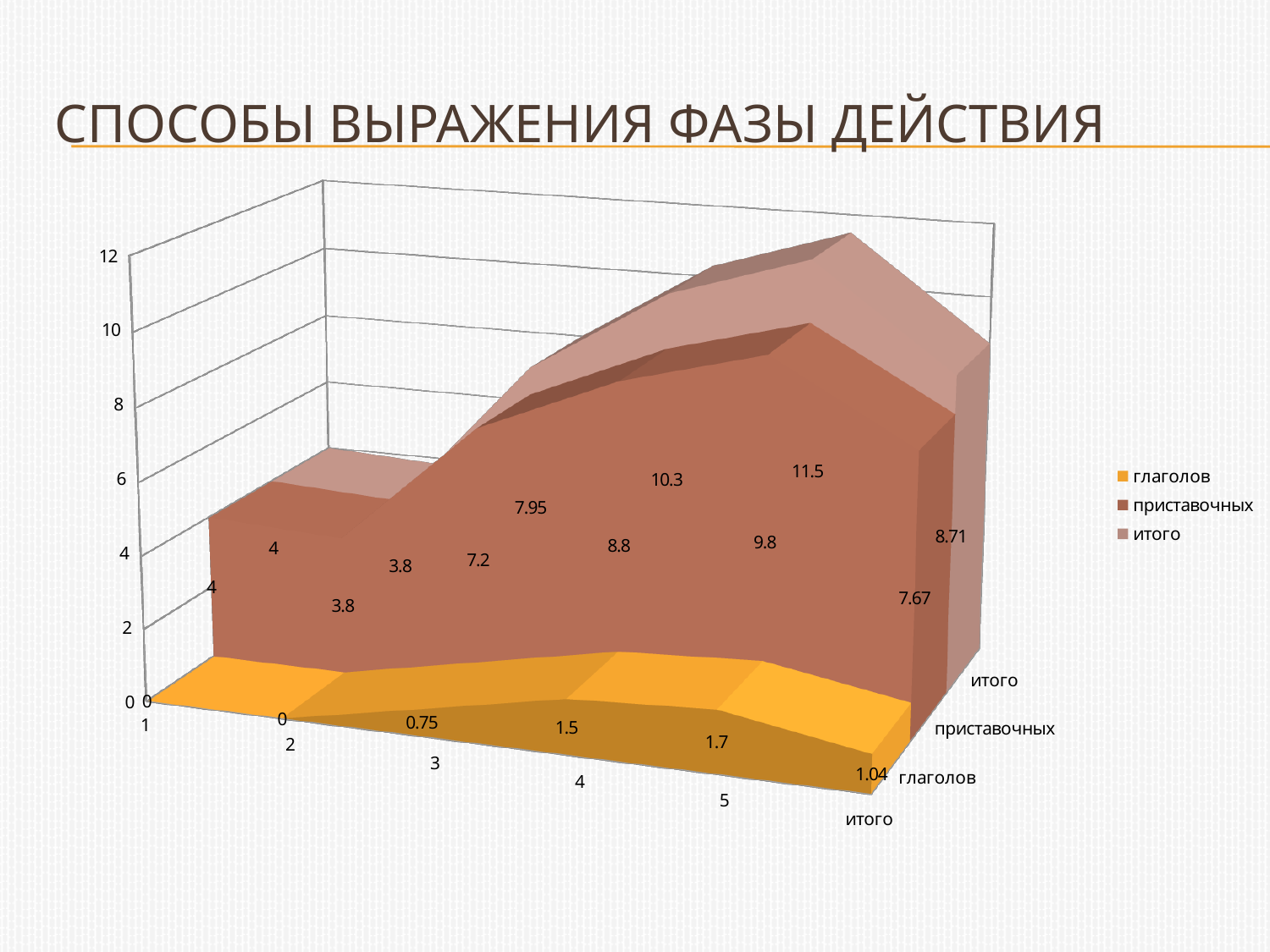
What is the difference between the итого and приставочных values for category 4? 1.5 How many categories are shown along the x axis? 6 For which category is the приставочных series highest? 5 What is the title of the chart? СПОСОБЫ ВЫРАЖЕНИЯ ФАЗЫ ДЕЙСТВИЯ Which is larger: the глаголов value for category 4 or for category 5? category 5 What is the value of the приставочных series for category 3? 7.2 What is the value of the глаголов series for the итого category? 1.04 Does the приставочных series rise or fall from category 2 to category 5? rise How many series does the legend list? 3 What type of chart is shown on the slide? area chart For which category is the итого series lowest? 2 What is the value of the итого series for category 5? 11.5